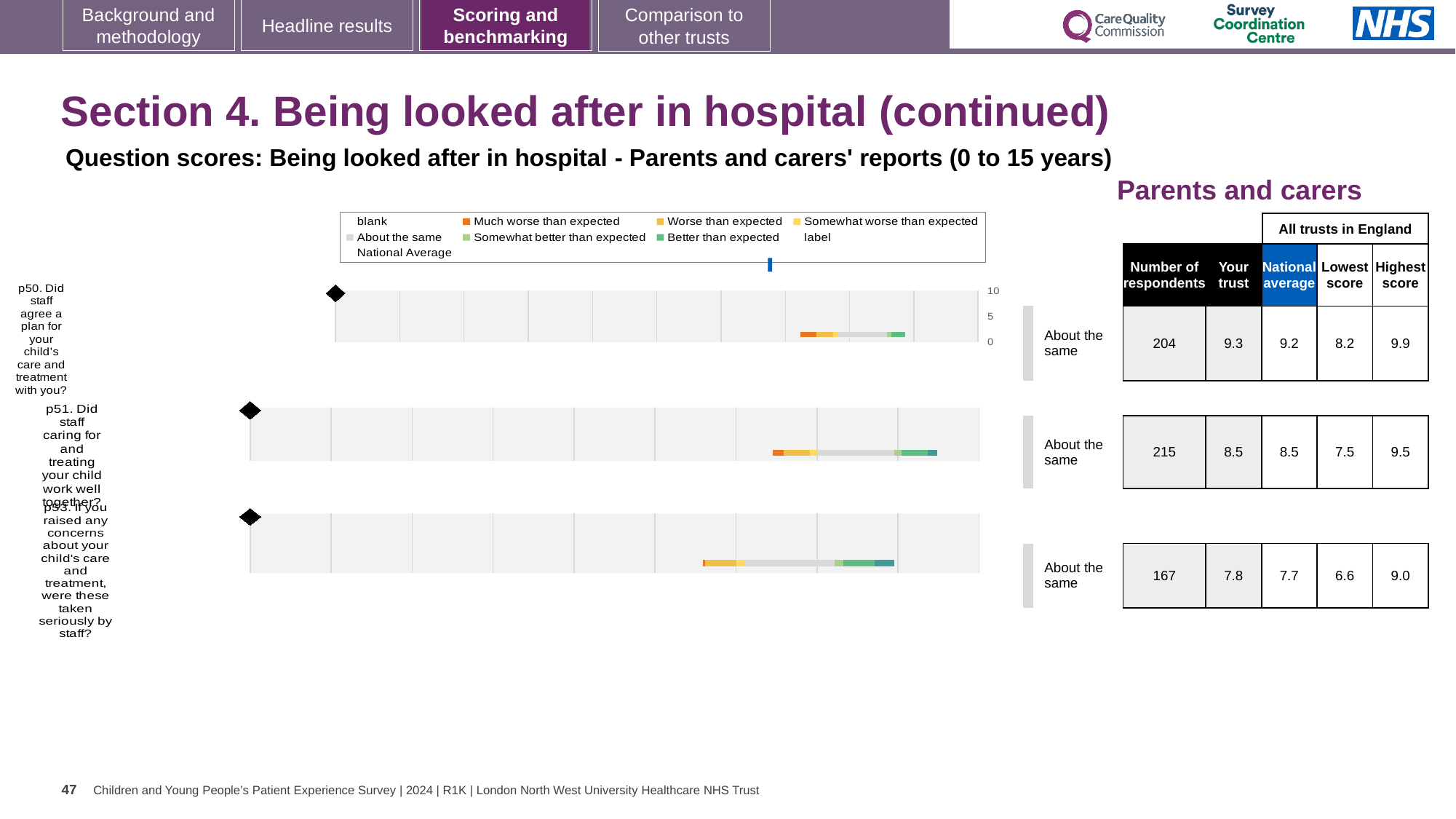
What kind of chart is used to show the question scores on this slide? bar chart What is the national average score for question p53 (If you raised any concerns about your child's care and treatment, were these taken seriously by staff?)? 7.7 Which question has the highest 'Your trust' score? p50 How many respondents are listed for question p50 (Did staff agree a plan for your child's care and treatment with you?)? 204 For question p50, what is the difference between the highest score (9.9) and the lowest score (8.2) among all trusts in England? 1.7 What benchmark category is shown next to each of the three questions on the slide? About the same For question p53, which is larger: the 'Your trust' score or the national average? Your trust What is the 'Your trust' score for question p51 (Did staff caring for and treating your child work well together?)? 8.5 What is the highest score among all trusts in England for question p51? 9.5 In the chart legend, which colour represents 'Much worse than expected'? orange How many survey questions (p50, p51, p53) are plotted on the slide? 3 Which question has the lowest number of respondents? p53